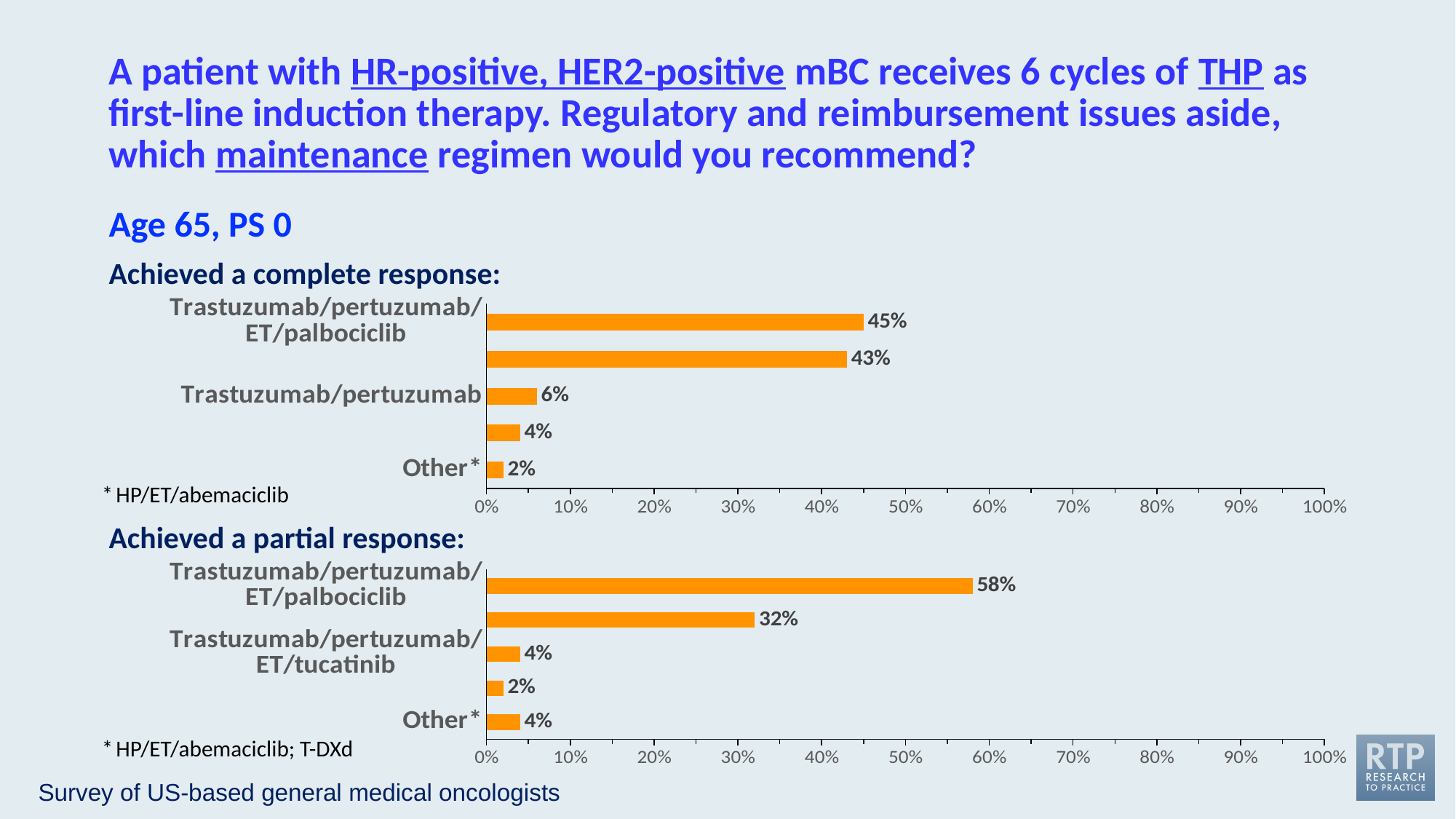
How many bars are shown in the 'Achieved a partial response' chart? 5 Which is larger: the value for Trastuzumab/pertuzumab/ET/palbociclib in the 'Achieved a complete response' chart or in the 'Achieved a partial response' chart? Achieved a partial response In the 'Achieved a complete response' chart, what is the difference in percentage points between Trastuzumab/pertuzumab/ET/palbociclib and Trastuzumab/pertuzumab? 39 percentage points In the 'Achieved a partial response' chart, what percentage chose Trastuzumab/pertuzumab/ET/tucatinib? 4% In the 'Achieved a complete response' chart, what percentage chose Trastuzumab/pertuzumab? 6% In the 'Achieved a complete response' chart, what is the value for Other*? 2% In the 'Achieved a complete response' chart, which category has the highest value? Trastuzumab/pertuzumab/ET/palbociclib In the 'Achieved a partial response' chart, what percentage chose Trastuzumab/pertuzumab/ET/palbociclib? 58% In the 'Achieved a partial response' chart, what is the difference in percentage points between Trastuzumab/pertuzumab/ET/palbociclib and Other*? 54 percentage points In the 'Achieved a complete response' chart, which labeled category has the lowest value? Other* In the 'Achieved a complete response' chart, what percentage chose Trastuzumab/pertuzumab/ET/palbociclib? 45% In the 'Achieved a partial response' chart, which category has the highest value? Trastuzumab/pertuzumab/ET/palbociclib